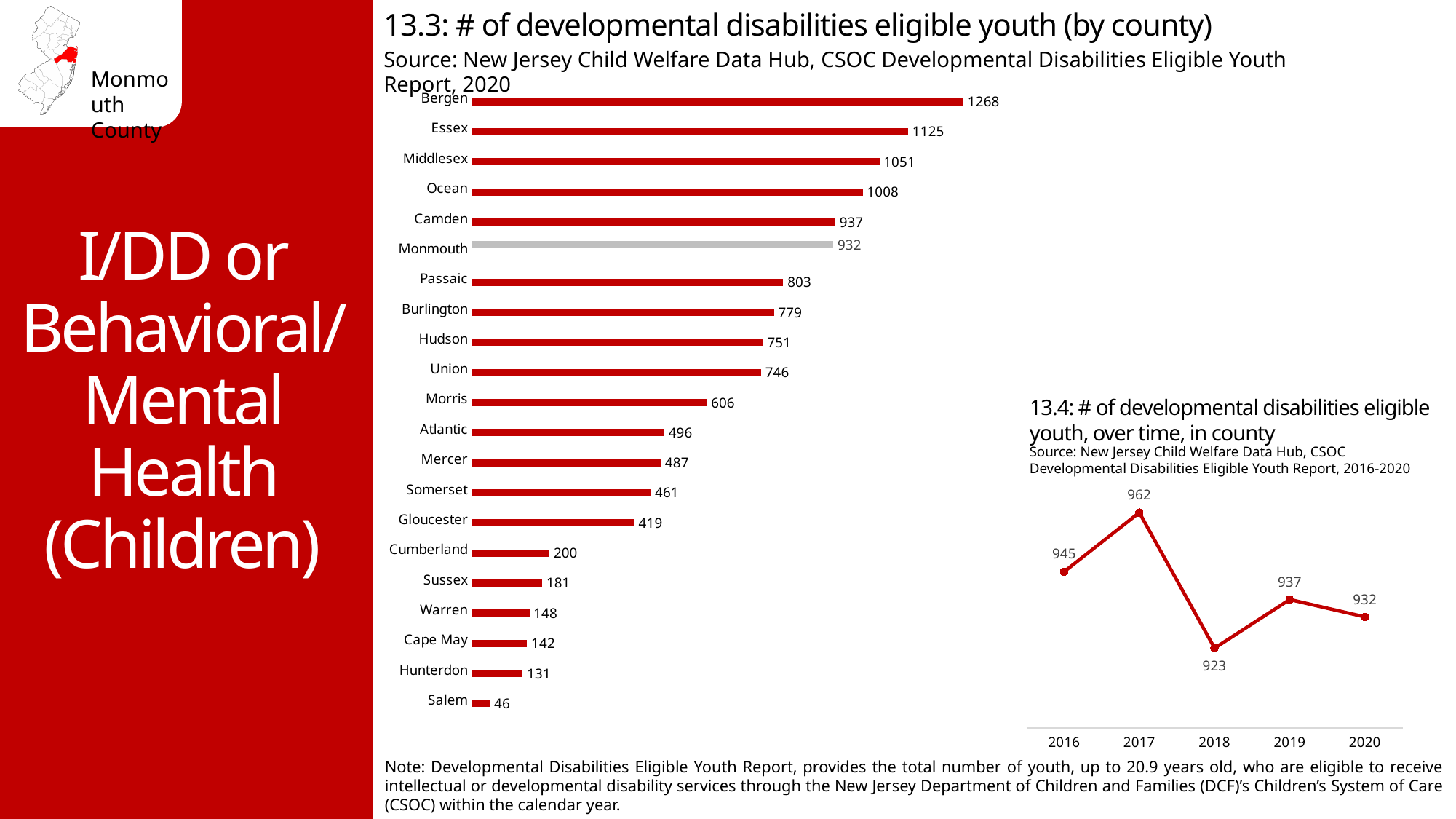
What kind of chart is chart 13.3 (# of developmental disabilities eligible youth by county)? Bar chart In chart 13.3 (by county), what is the value for Gloucester? 419 In chart 13.3 (by county), which county has the highest number of developmental disabilities eligible youth? Bergen In chart 13.3 (# of developmental disabilities eligible youth by county), what is the value for Monmouth? 932 In chart 13.4 (over time, in county), how many years are plotted? 5 In chart 13.4 (over time, in county), what is the value for 2017? 962 In chart 13.4 (over time, in county), what is the difference between the values for 2017 and 2018? 39 In chart 13.3 (by county), which has a larger value, Camden or Passaic? Camden In chart 13.4 (over time, in county), which year has the lowest value? 2018 In chart 13.3 (by county), which county has the lowest number of developmental disabilities eligible youth? Salem In chart 13.3 (by county), how many counties are shown? 21 In chart 13.3 (by county), what is the difference between the values for Bergen and Essex? 143